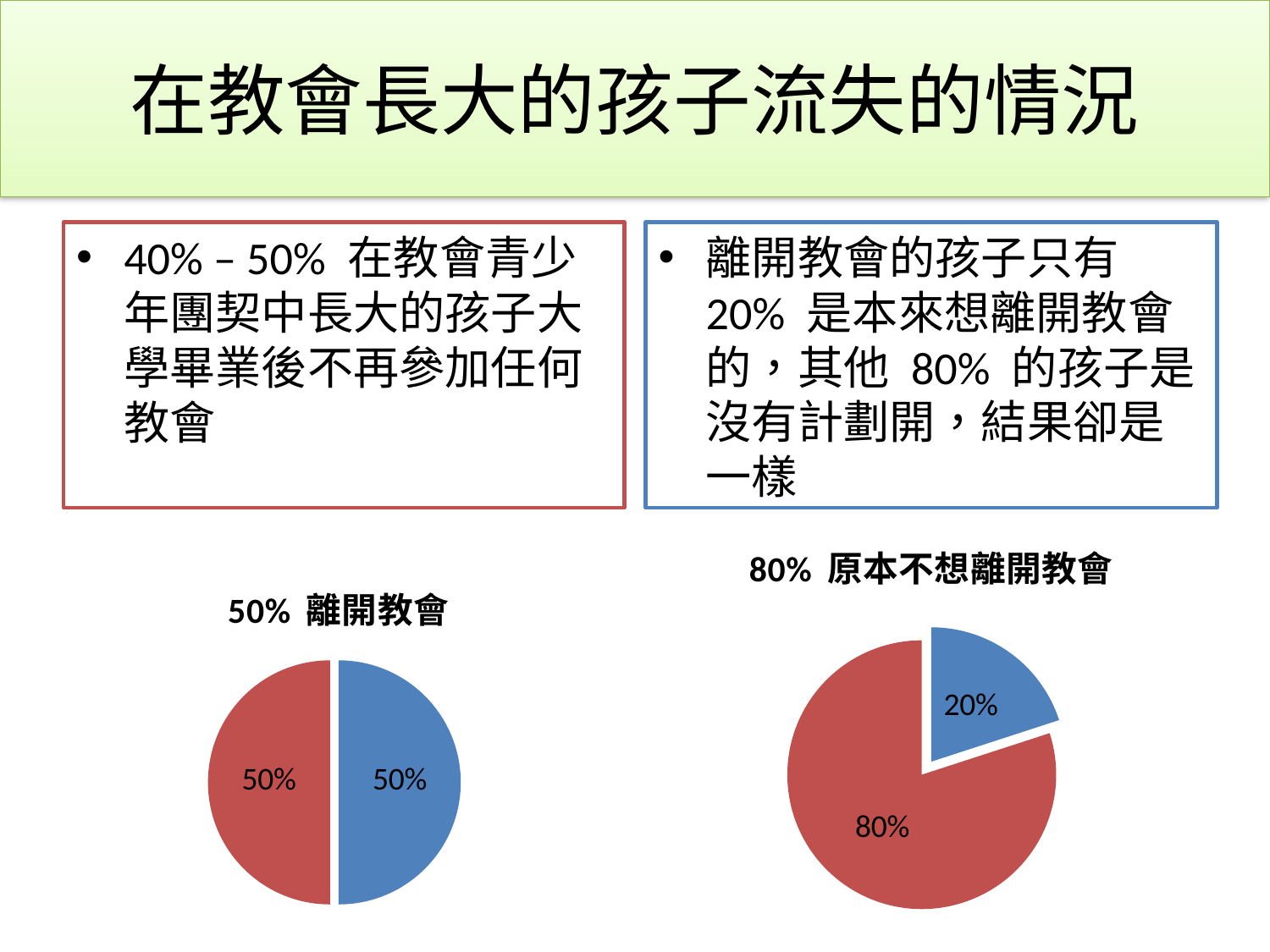
What kind of chart is the chart titled "80% 原本不想離開教會"? pie chart What is the title of the pie chart on the left of the slide? 50% 離開教會 In the chart titled "50% 離開教會", what value is shown on the blue slice? 50% In the chart titled "50% 離開教會", what value is shown on the red slice? 50% In the chart titled "80% 原本不想離開教會", which slice is larger, the red one or the blue one? the red one In the chart titled "80% 原本不想離開教會", what value is shown on the red slice? 80% How many slices does the chart titled "80% 原本不想離開教會" have? 2 In the chart titled "80% 原本不想離開教會", what value is shown on the blue slice? 20% How many slices does the chart titled "50% 離開教會" have? 2 How many pie charts are shown on the slide? 2 In the chart titled "80% 原本不想離開教會", what is the difference between the red slice and the blue slice? 60% What kind of chart is the chart titled "50% 離開教會"? pie chart